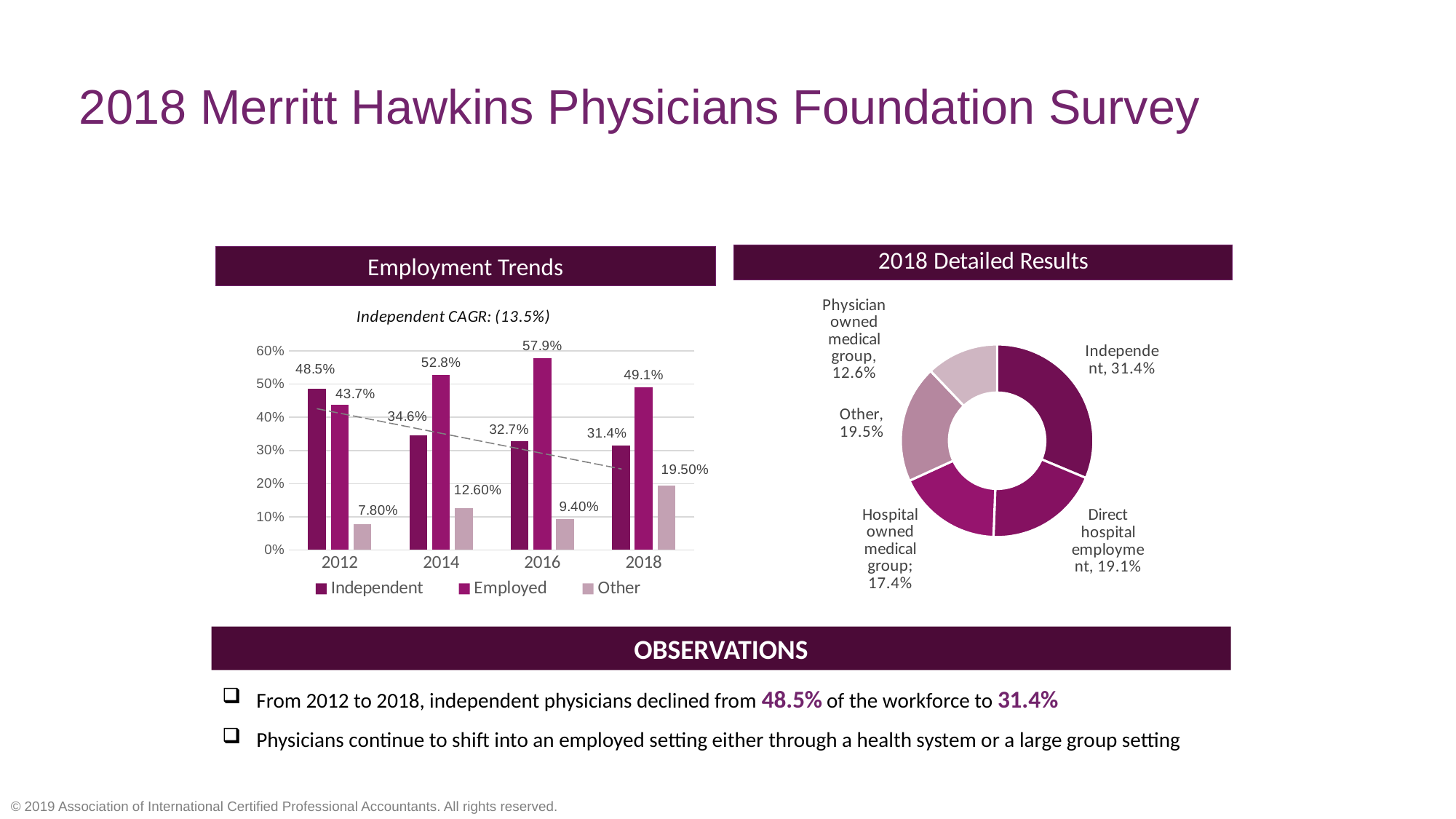
How many categories are shown in the 2018 Detailed Results chart? 5 In the Employment Trends chart, what is the Independent value for 2012? 48.5% In the Employment Trends chart, which year has the lowest Other value? 2012 In the 2018 Detailed Results chart, what share does Direct hospital employment have? 19.1% In the Employment Trends chart, which year has the highest Employed value? 2016 How many series does the legend of the Employment Trends chart list? 3 In the Employment Trends chart, what is the Employed value for 2016? 57.9% In the Employment Trends chart, what is the difference between the Independent values for 2012 and 2018? 17.1% In the 2018 Detailed Results chart, which category has the smallest share? Physician owned medical group In the Employment Trends chart, what is the Other value for 2018? 19.50% What kind of chart is the Employment Trends chart? bar chart In the Employment Trends chart, does the Independent series rise or fall from 2012 to 2018? fall